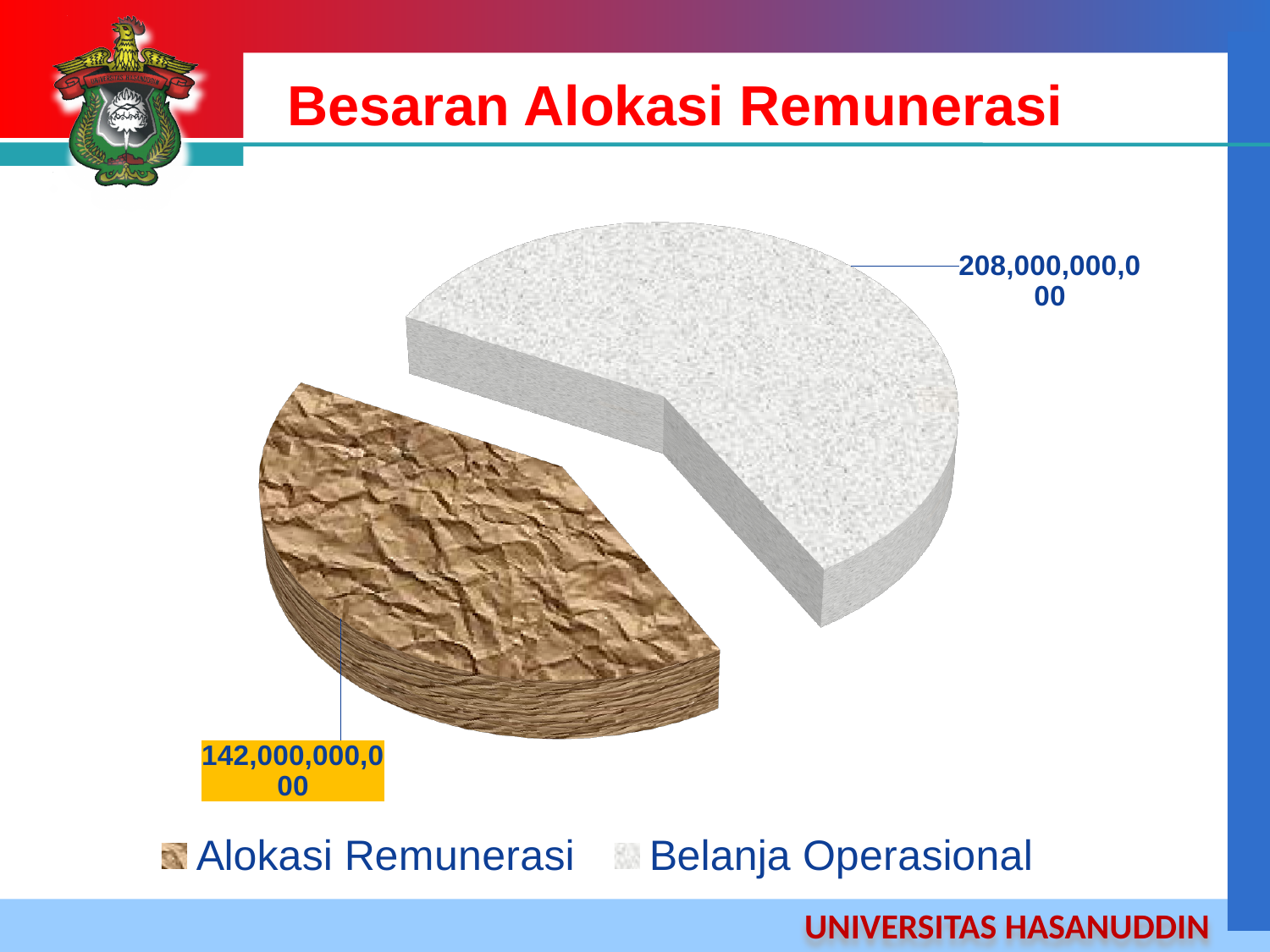
How many slices does the pie chart have? 2 Which slice is the largest? Belanja Operasional How many entries does the legend list? 2 Which legend entry is shown with the brown textured slice? Alokasi Remunerasi What is the difference between Belanja Operasional and Alokasi Remunerasi? 66,000,000,000 Which slice is the smallest? Alokasi Remunerasi What is the value for Belanja Operasional? 208,000,000,000 What kind of chart is shown on the slide? pie chart Which is larger, Alokasi Remunerasi or Belanja Operasional? Belanja Operasional What is the title of the chart? Besaran Alokasi Remunerasi What is the total of the two slices? 350,000,000,000 What is the value for Alokasi Remunerasi? 142,000,000,000